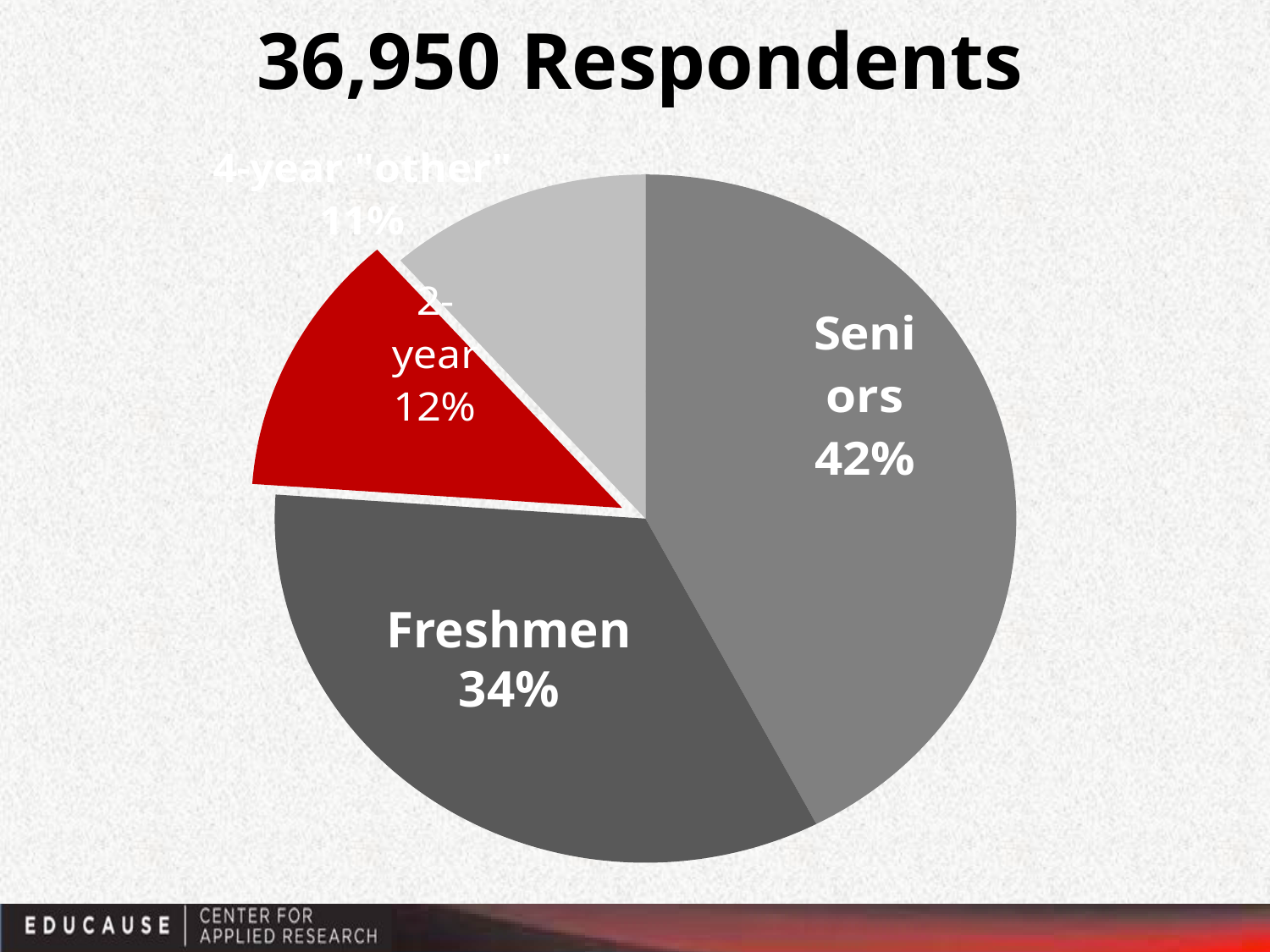
What share of respondents are Seniors? 42% Which slice of the pie is coloured red? 2-year What share of respondents are from 2-year institutions? 12% What is the difference in percentage points between the Seniors and Freshmen shares? 8 What share of respondents are in the 4-year "other" category? 11% What is the title of the chart? 36,950 Respondents How many slices does the pie chart have? 4 What share of respondents are Freshmen? 34% Which is larger, the Freshmen share or the 2-year share? Freshmen What kind of chart is shown on the slide? pie chart Which category has the largest share of respondents? Seniors Which category has the smallest share of respondents? 4-year "other"